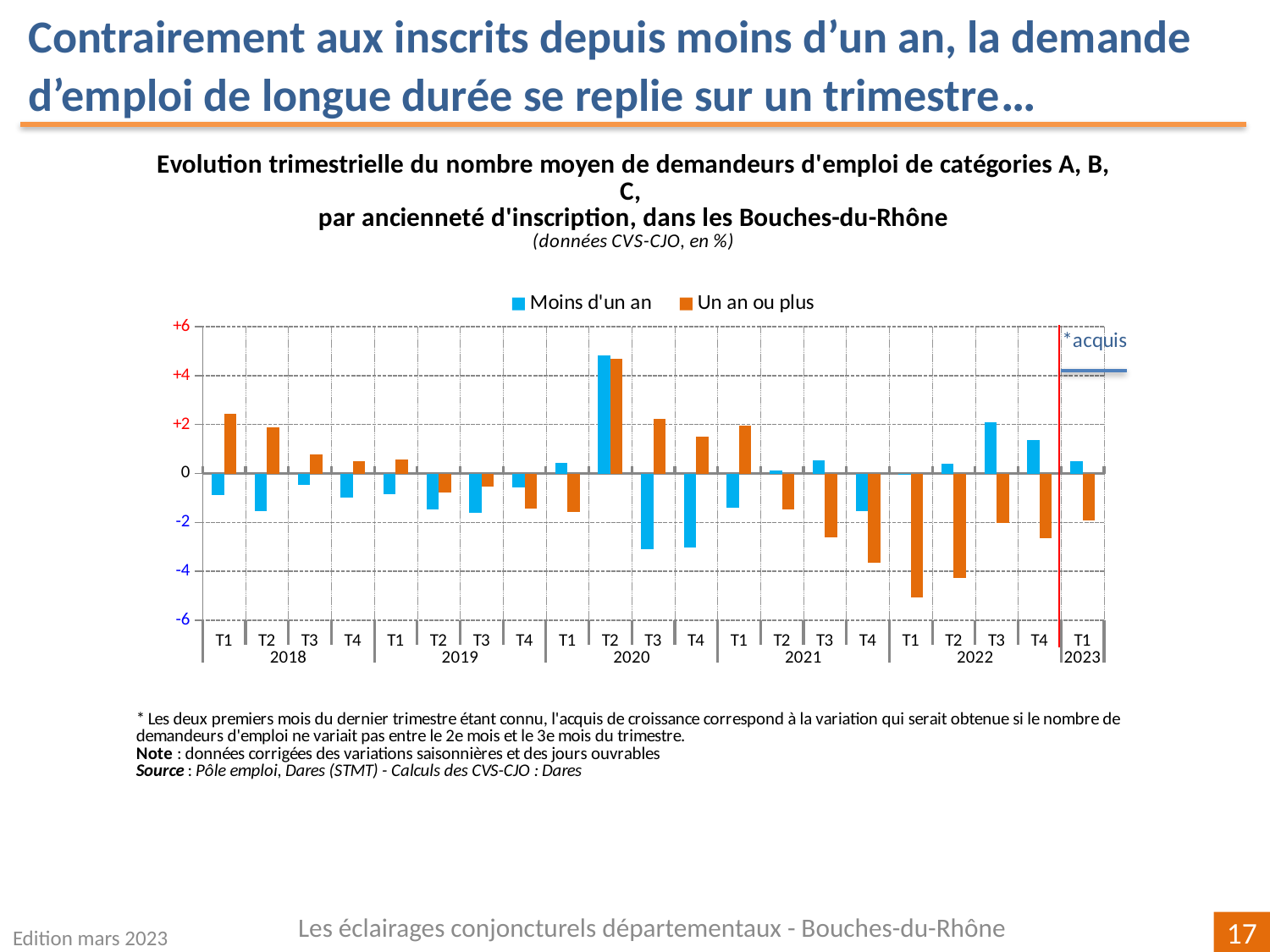
How many series does the legend list? 2 Is the value for 'Un an ou plus' in T1 2022 greater or less than -4? less What are the two series named in the legend? Moins d'un an; Un an ou plus In which quarter is the value for 'Un an ou plus' highest? T2 2020 Is the value for 'Un an ou plus' in T4 2021 greater or less than -2? less In which quarter is the value for 'Un an ou plus' lowest? T1 2022 What kind of chart is shown on the slide? Bar chart In T1 2023, which series has the larger value, 'Moins d'un an' or 'Un an ou plus'? Moins d'un an Is the value for 'Moins d'un an' in T2 2020 greater or less than +4? greater In T1 2018, which series has the larger value, 'Moins d'un an' or 'Un an ou plus'? Un an ou plus In which quarter is the value for 'Moins d'un an' highest? T2 2020 How many quarters are plotted along the x axis? 21